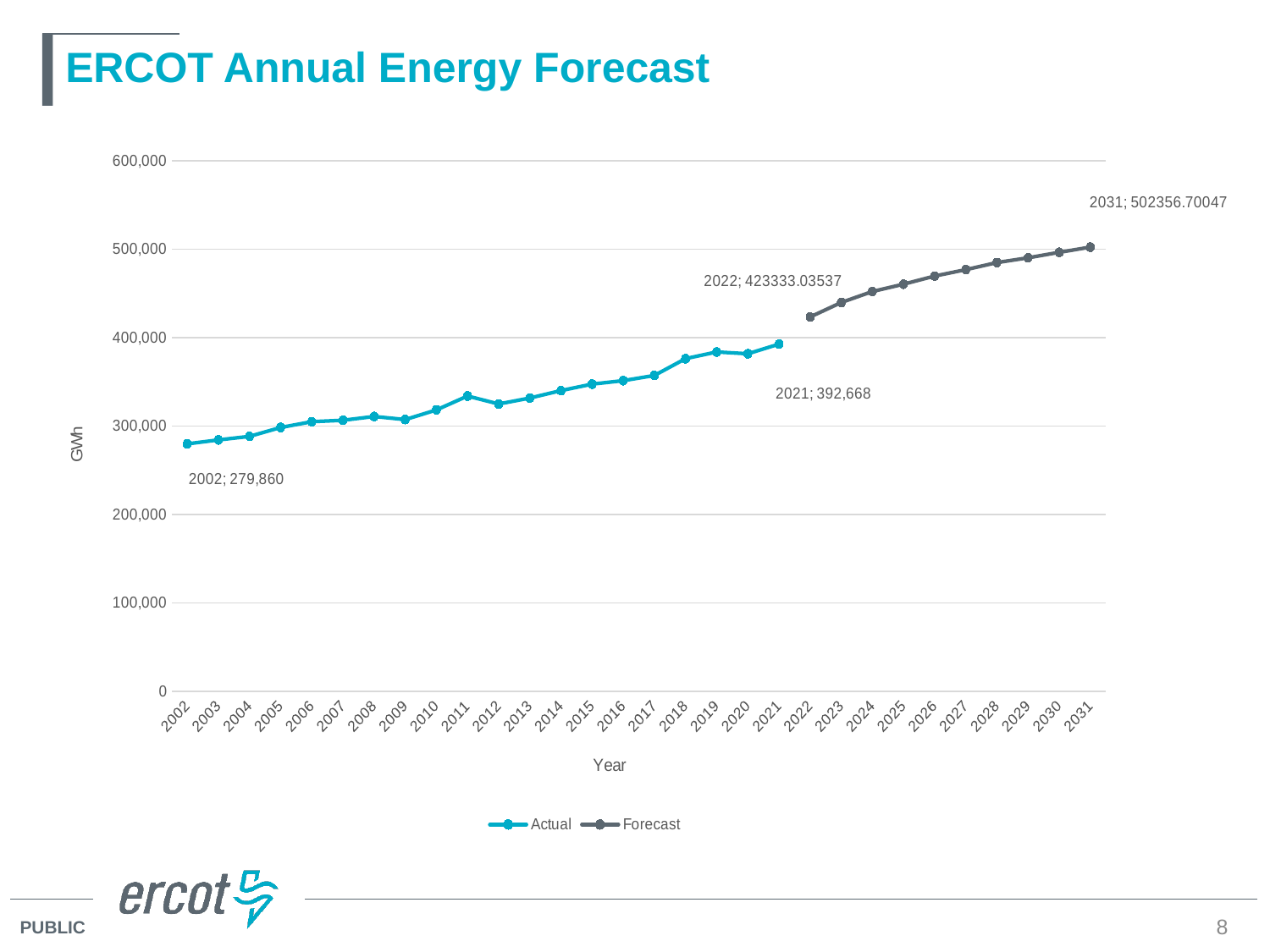
What is the Actual value for 2021? 392,668 Which year has the lowest value on the chart? 2002 What kind of chart is shown on the slide? line chart What is the difference between the Actual values for 2021 and 2002? 112,808 Is the value for 2011 greater or less than 300,000? greater What is the Actual value for 2002? 279,860 Is the value for 2025 greater or less than 500,000? less What is the Forecast value for 2031? 502356.70047 Which year has the highest value on the chart? 2031 How many series does the legend list? 2 What is the Forecast value for 2022? 423333.03537 Which is larger, the value for 2022 or the value for 2021? 2022